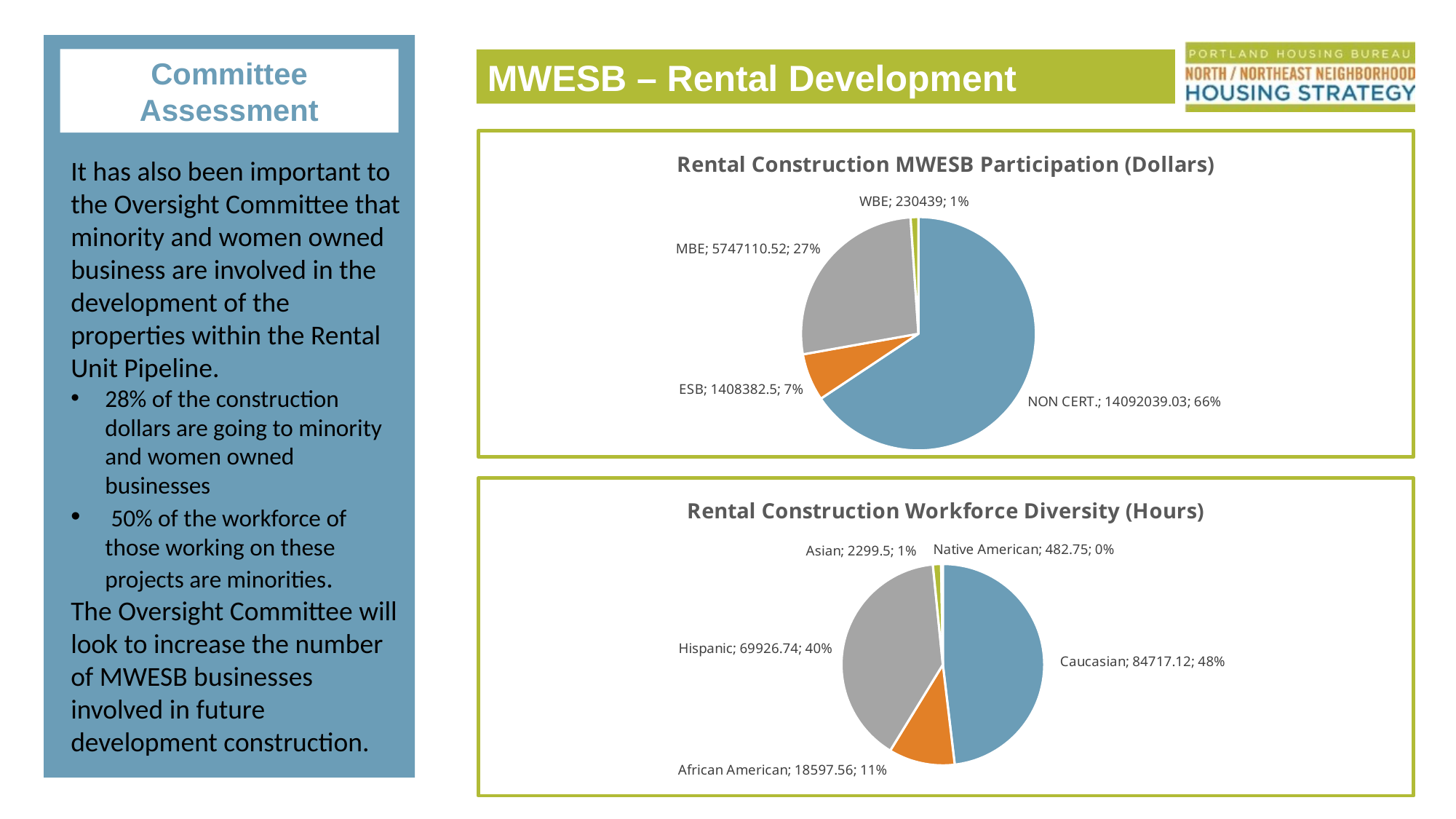
In the 'Rental Construction MWESB Participation (Dollars)' chart, which category has the smallest slice? WBE In the 'Rental Construction MWESB Participation (Dollars)' chart, what is the value for MBE? 5747110.52 What type of chart is 'Rental Construction Workforce Diversity (Hours)'? Pie chart How many categories are shown in the 'Rental Construction MWESB Participation (Dollars)' chart? 4 In the 'Rental Construction MWESB Participation (Dollars)' chart, what is the difference between the MBE and ESB values? 4338728.02 In the 'Rental Construction Workforce Diversity (Hours)' chart, what is the difference between the Caucasian and Hispanic values? 14790.38 In the 'Rental Construction Workforce Diversity (Hours)' chart, which is larger, African American or Asian? African American In the 'Rental Construction Workforce Diversity (Hours)' chart, which category has the largest slice? Caucasian How many categories are shown in the 'Rental Construction Workforce Diversity (Hours)' chart? 5 In the 'Rental Construction Workforce Diversity (Hours)' chart, what is the value for Hispanic? 69926.74 In the 'Rental Construction MWESB Participation (Dollars)' chart, what share of the pie does NON CERT. represent? 66% In the 'Rental Construction Workforce Diversity (Hours)' chart, what share of the pie does Native American represent? 0%